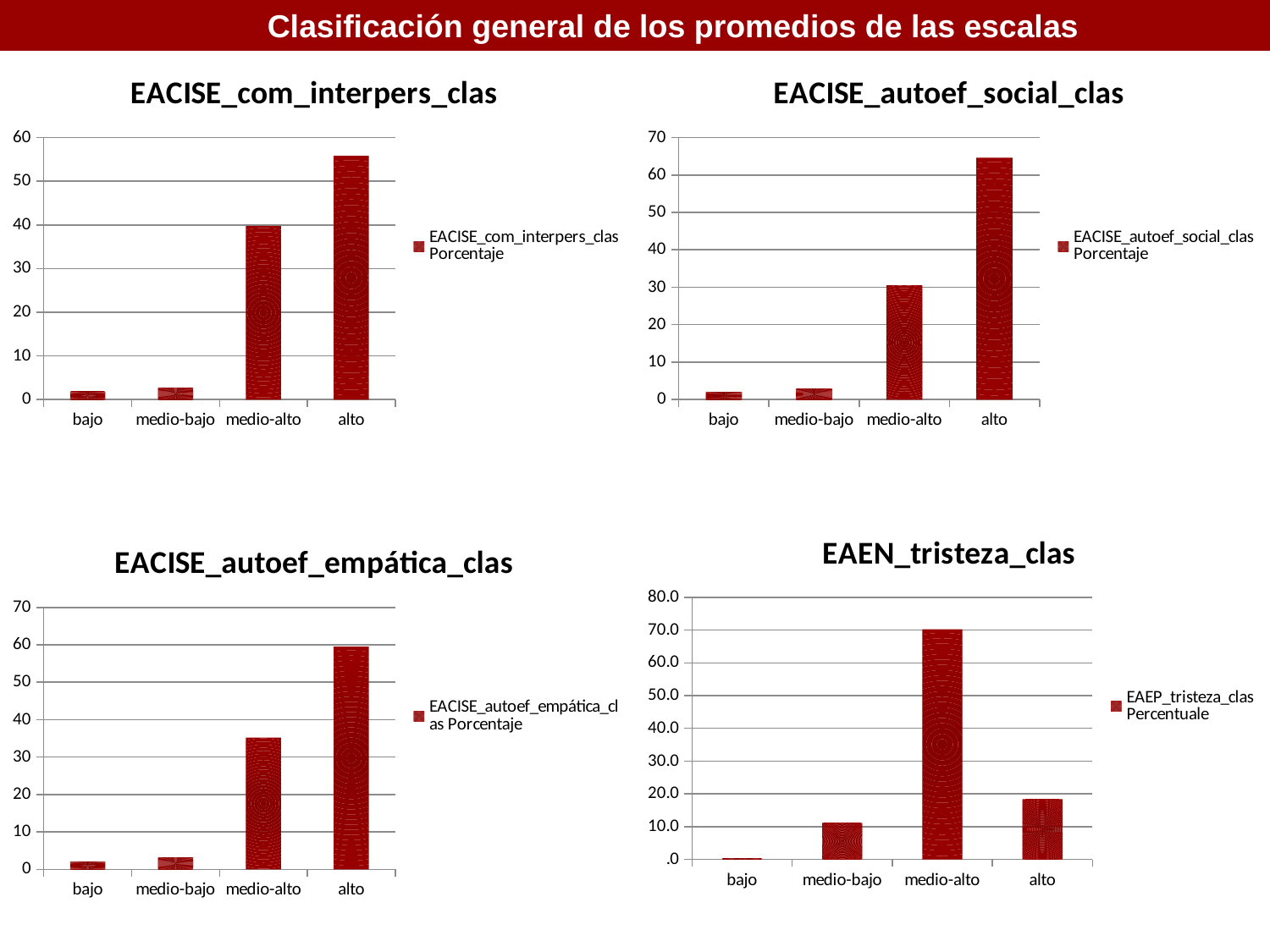
In the EACISE_com_interpers_clas chart, is the value for alto greater or less than 50? greater In the EAEN_tristeza_clas chart, which category has the highest value? medio-alto In the EACISE_autoef_social_clas chart, is the value for alto greater or less than 60? greater In the EAEN_tristeza_clas chart, is the value for medio-alto greater or less than 60.0? greater In the EACISE_com_interpers_clas chart, which category has the highest value? alto In the EACISE_autoef_social_clas chart, which category has the highest value? alto How many categories are shown on the x axis of the EAEN_tristeza_clas chart? 4 In the EAEN_tristeza_clas chart, which category has the lowest value? bajo What kind of chart is the EACISE_com_interpers_clas chart? bar chart In the EACISE_autoef_empática_clas chart, which is larger, the value for alto or the value for medio-alto? alto